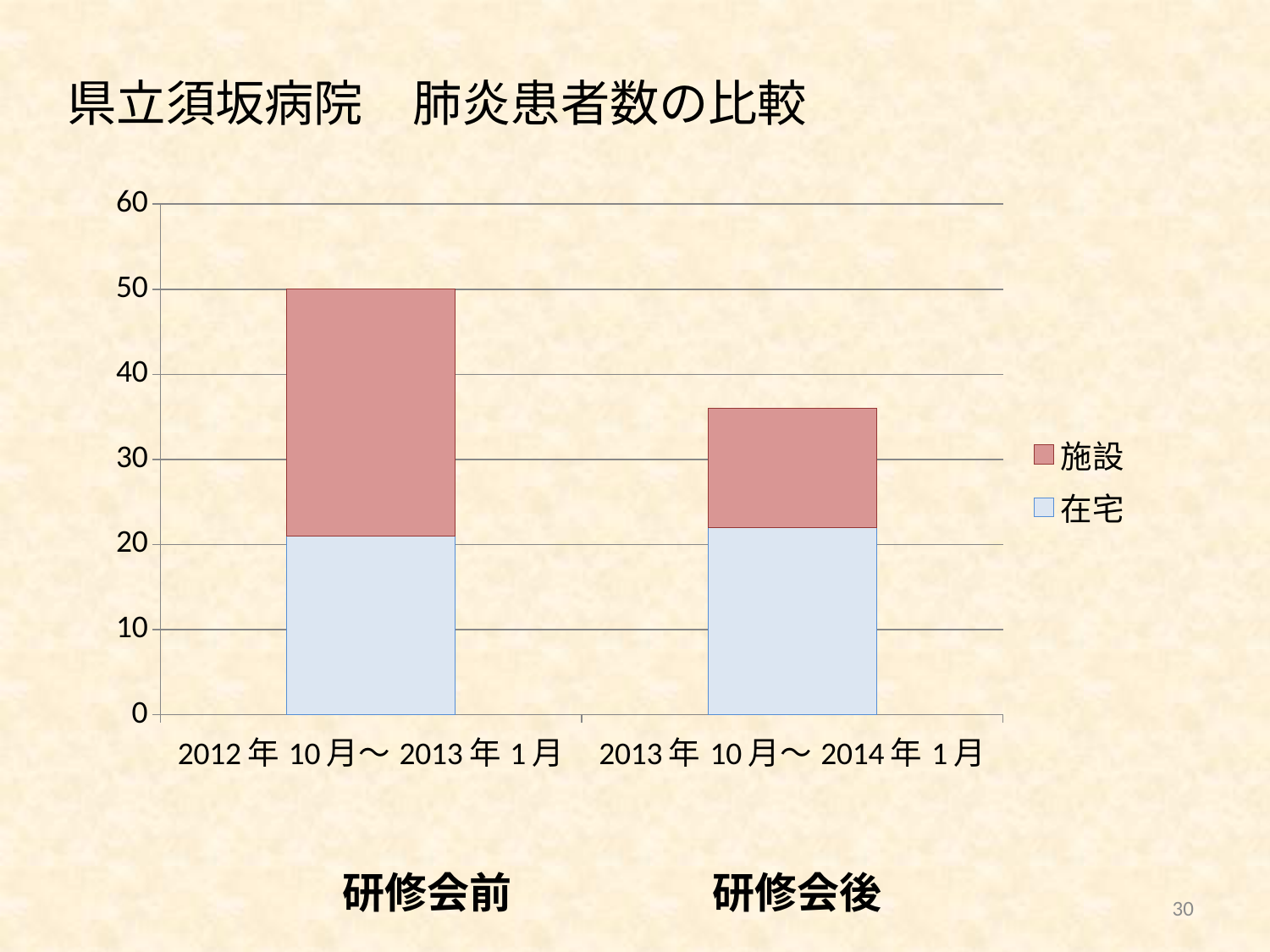
Which period has the higher total stacked bar? 2012年10月～2013年1月 What is the title of the slide containing the chart? 県立須坂病院 肺炎患者数の比較 How many categories (time periods) are shown on the x axis? 2 How many series does the legend list? 2 What is the total height of the stacked bar for 2012年10月～2013年1月? 50 Which period has the lower total stacked bar? 2013年10月～2014年1月 Is the 在宅 value for 2012年10月～2013年1月 greater or less than 30? less What kind of chart is shown on the slide? Stacked bar chart What are the two series listed in the legend? 施設 and 在宅 Which period has the larger 施設 segment? 2012年10月～2013年1月 Is the total for 2013年10月～2014年1月 greater or less than 30? greater Is the total for 2013年10月～2014年1月 greater or less than 40? less